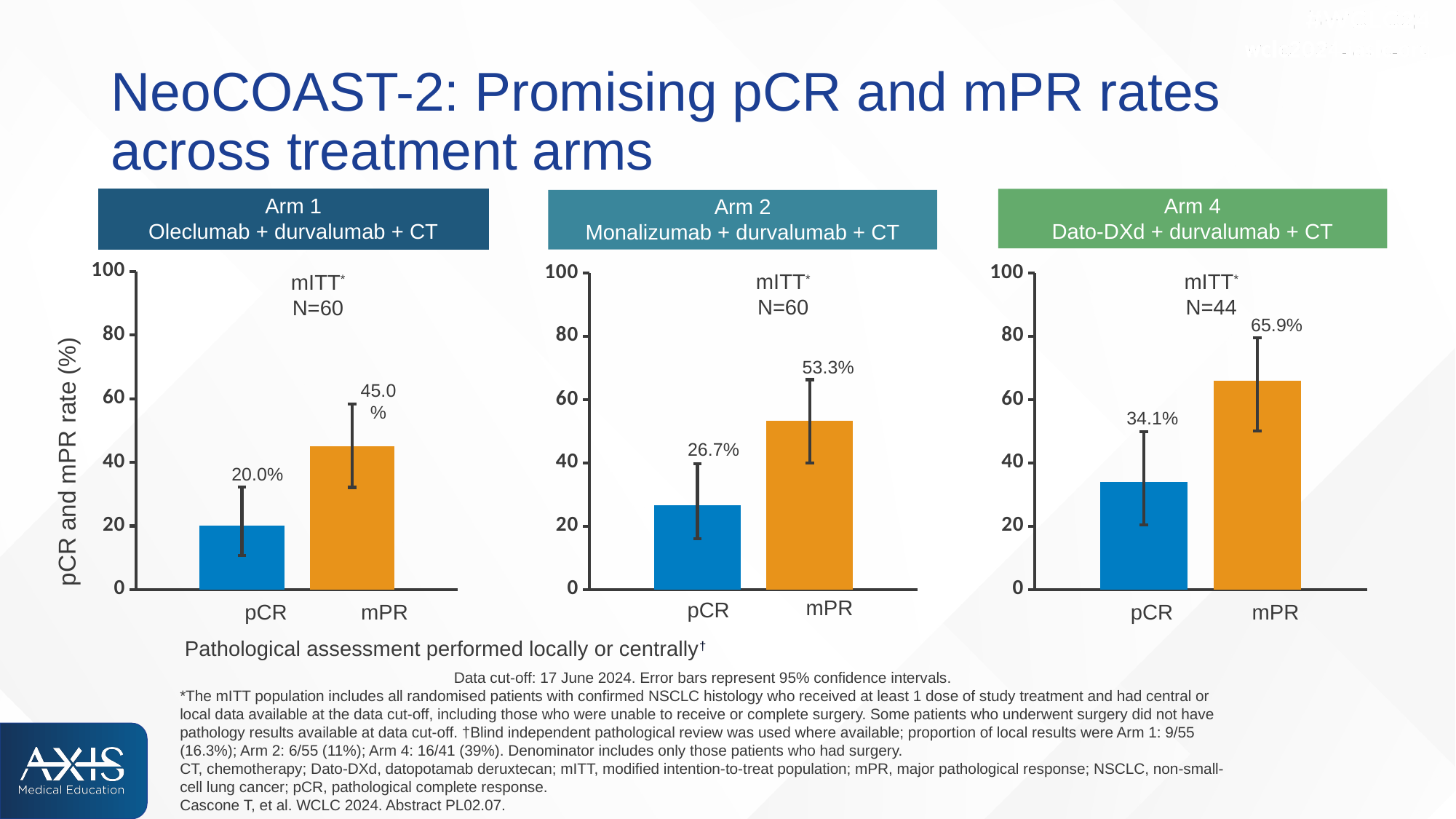
In the Arm 4 (Dato-DXd + durvalumab + CT) chart, what is the pCR rate? 34.1% In the Arm 1 (Oleclumab + durvalumab + CT) chart, what is the pCR rate? 20.0% What kind of chart is used for each treatment arm on this slide? Bar chart In the Arm 2 (Monalizumab + durvalumab + CT) chart, what is the mPR rate? 53.3% In the Arm 2 (Monalizumab + durvalumab + CT) chart, what is the pCR rate? 26.7% Across the three charts, which arm has the lowest pCR rate? Arm 1 How many bars are plotted in the Arm 1 (Oleclumab + durvalumab + CT) chart? 2 In the Arm 4 (Dato-DXd + durvalumab + CT) chart, what is the difference between the mPR rate and the pCR rate? 31.8% In the Arm 1 (Oleclumab + durvalumab + CT) chart, what is the mPR rate? 45.0% Across the three charts, which arm has the highest mPR rate? Arm 4 In the Arm 2 (Monalizumab + durvalumab + CT) chart, which is larger, the pCR rate or the mPR rate? mPR In the Arm 4 (Dato-DXd + durvalumab + CT) chart, what is the mPR rate? 65.9%